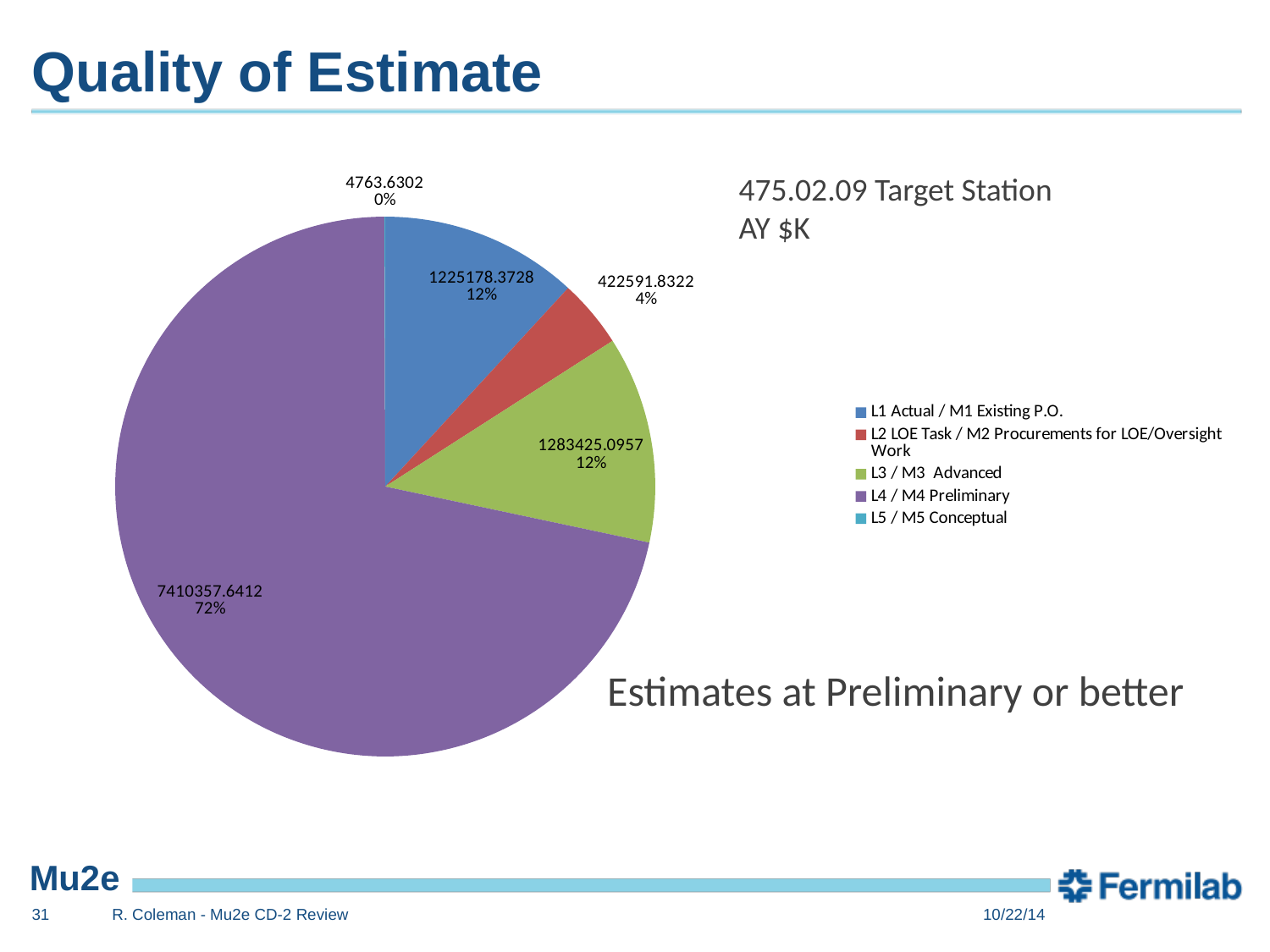
Which category has the smallest slice of the pie? L5 / M5 Conceptual Which is larger, the value for L4 / M4 Preliminary or the value for L3 / M3 Advanced? L4 / M4 Preliminary What is the value for L2 LOE Task / M2 Procurements for LOE/Oversight Work? 422591.8322 How many entries does the legend list? 5 What is the value for L5 / M5 Conceptual? 4763.6302 What share of the pie does L4 / M4 Preliminary represent? 72% What is the title shown next to the pie chart? 475.02.09 Target Station AY $K What kind of chart is shown on the slide? pie chart What is the value for L4 / M4 Preliminary? 7410357.6412 Which category has the largest slice of the pie? L4 / M4 Preliminary How many slices does the pie chart have? 5 What share of the pie does L2 LOE Task / M2 Procurements for LOE/Oversight Work represent? 4%